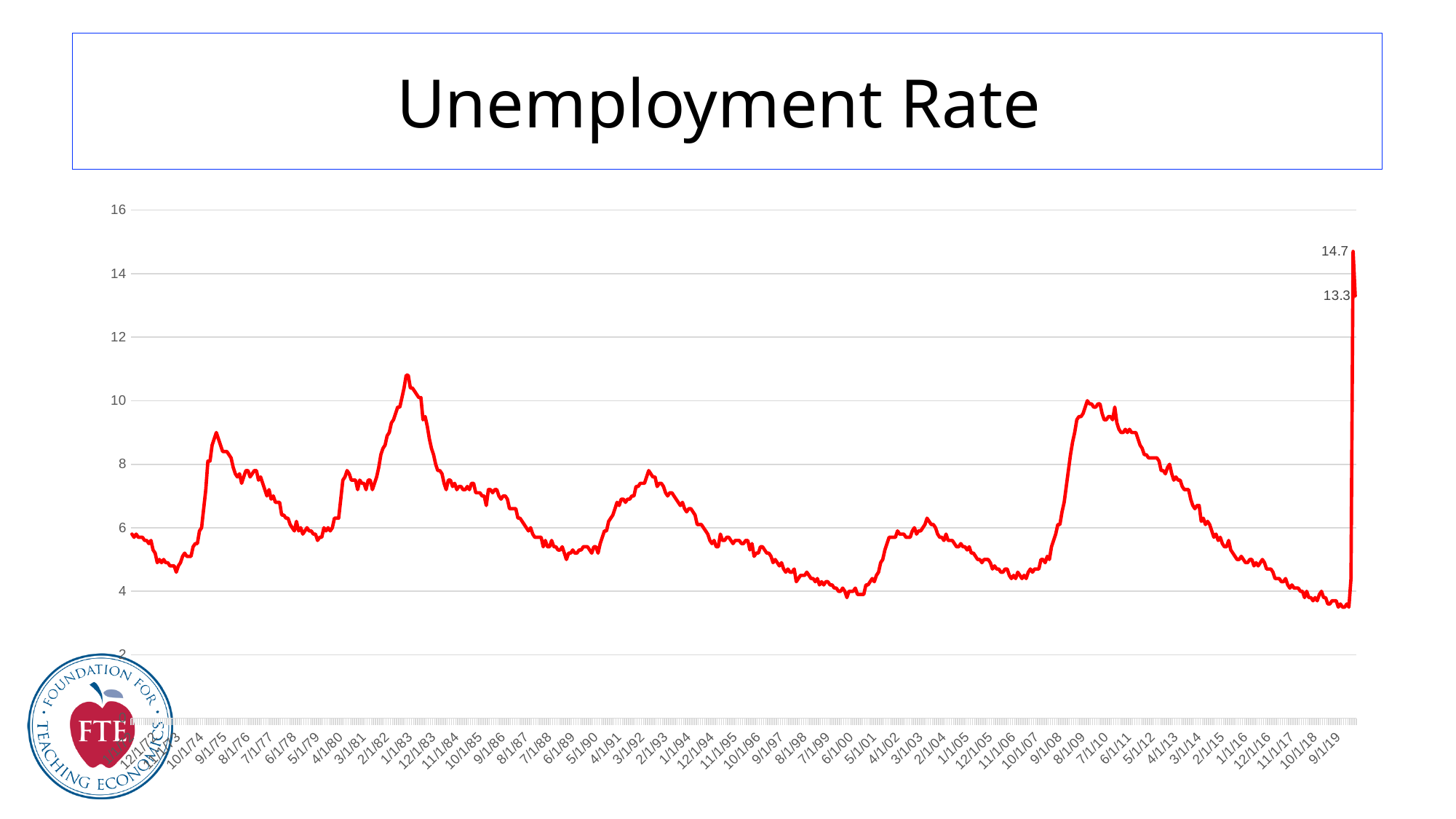
What colour is the plotted line? red Is the value of the line near 9/1/19, just before the final spike, greater or less than 4? less Is the peak of the line near 9/1/75 greater or less than 8? greater Which is higher: the peak near 1/1/83 or the peak near 9/1/75? the peak near 1/1/83 What is the value of the final labelled data point on the chart? 13.3 What is the title of the chart? Unemployment Rate Does the line generally rise or fall between 8/1/09 and 9/1/19? fall What is the highest value labelled on the chart? 14.7 Is the peak of the line near 1/1/83 greater or less than 10? greater Which is higher: the peak near 3/1/92 or the peak near 8/1/09? the peak near 8/1/09 What kind of chart is shown on the slide? line chart What is the difference between the two labelled values, 14.7 and 13.3? 1.4